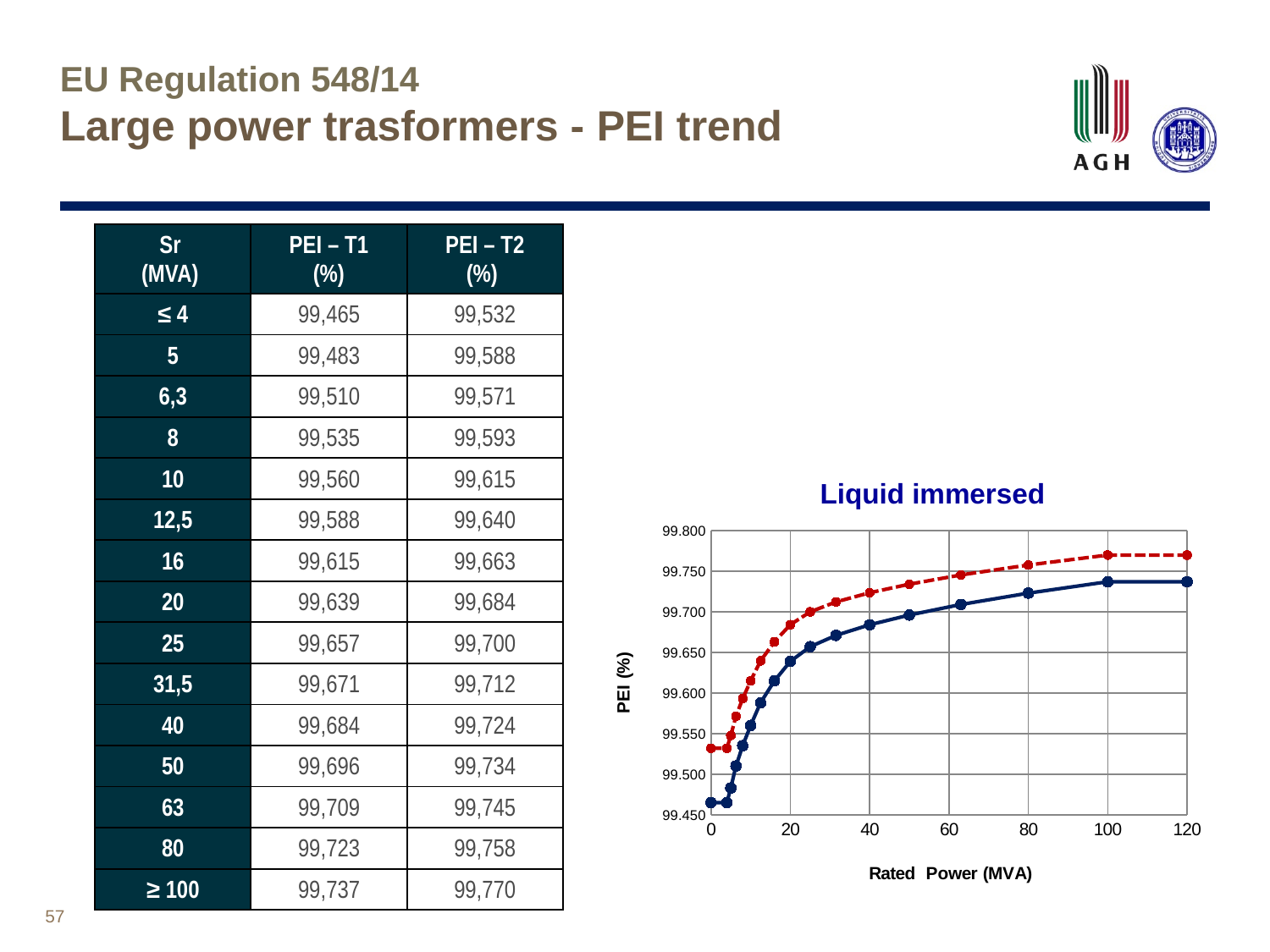
What is the x-axis title of the "Liquid immersed" chart? Rated Power (MVA) On the "Liquid immersed" chart, do the PEI values rise or fall as rated power increases? rise What is the title of the chart on the slide? Liquid immersed What kind of chart is the "Liquid immersed" chart? line chart On the "Liquid immersed" chart, is the value of the red dashed line at 0 MVA greater or less than 99.500? greater On the "Liquid immersed" chart, is the value of the red dashed line at 120 MVA greater or less than 99.750? greater How many lines are plotted on the "Liquid immersed" chart? 2 On the "Liquid immersed" chart, which line is higher at 60 MVA, the red dashed line or the blue solid line? red dashed line On the "Liquid immersed" chart, is the value of the blue solid line at 0 MVA greater or less than 99.500? less